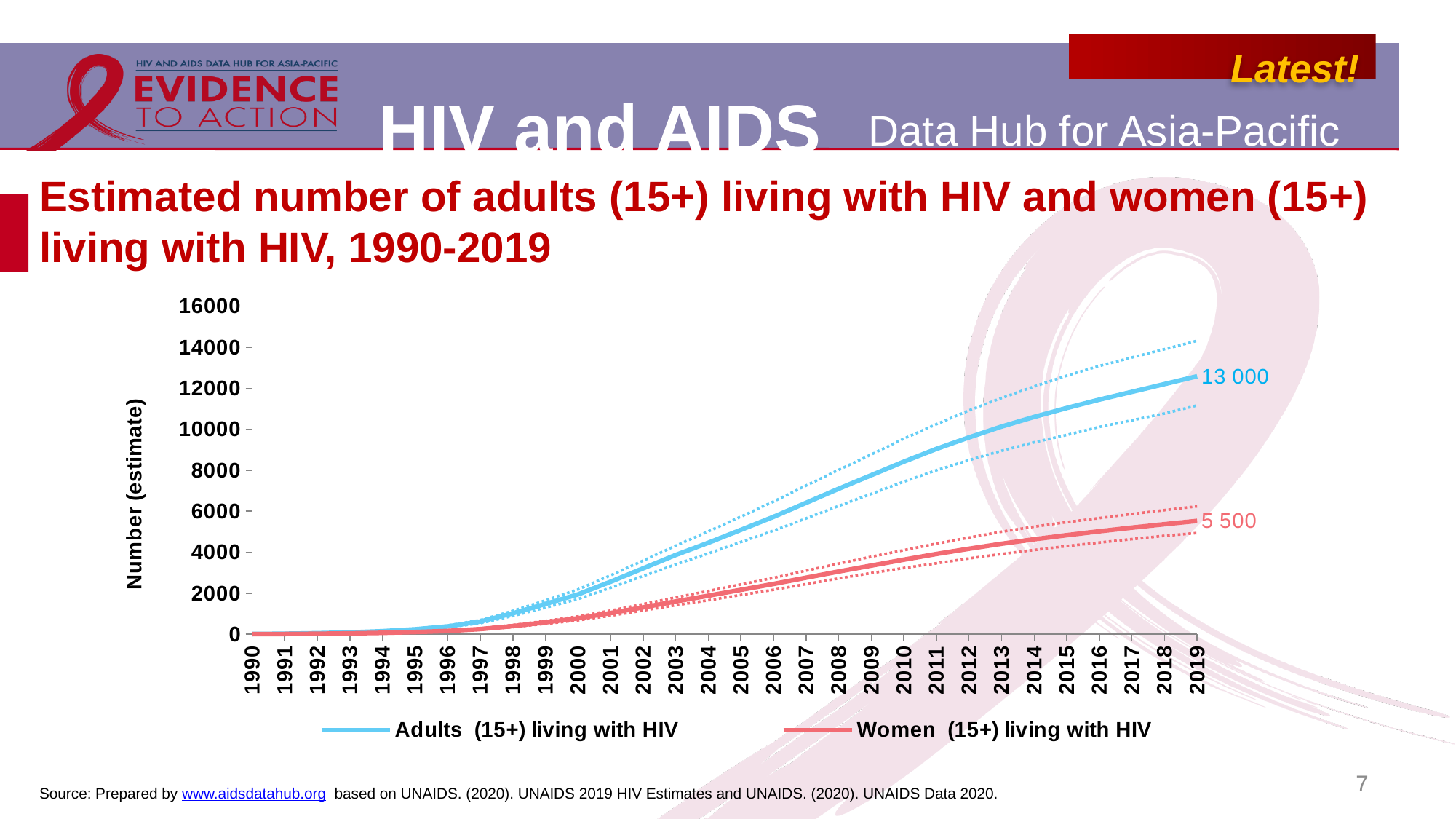
What is the estimated number of adults (15+) living with HIV in 2019? 13 000 Is the value for Adults (15+) living with HIV in 2000 greater or less than 4000? less What kind of chart is shown on the slide? Line chart Is the value for Adults (15+) living with HIV in 2005 greater or less than 6000? less How many years are shown on the x axis of the chart? 30 Do the values for Adults (15+) living with HIV rise or fall from 1990 to 2019? Rise How many series does the legend list? 2 What is the title of the y axis? Number (estimate) What is the estimated number of women (15+) living with HIV in 2019? 5 500 What is the difference between the 2019 values for adults (15+) and women (15+) living with HIV? 7 500 Is the value for Women (15+) living with HIV in 2015 greater or less than 4000? greater In 2019, which series has the larger value: Adults (15+) living with HIV or Women (15+) living with HIV? Adults (15+) living with HIV